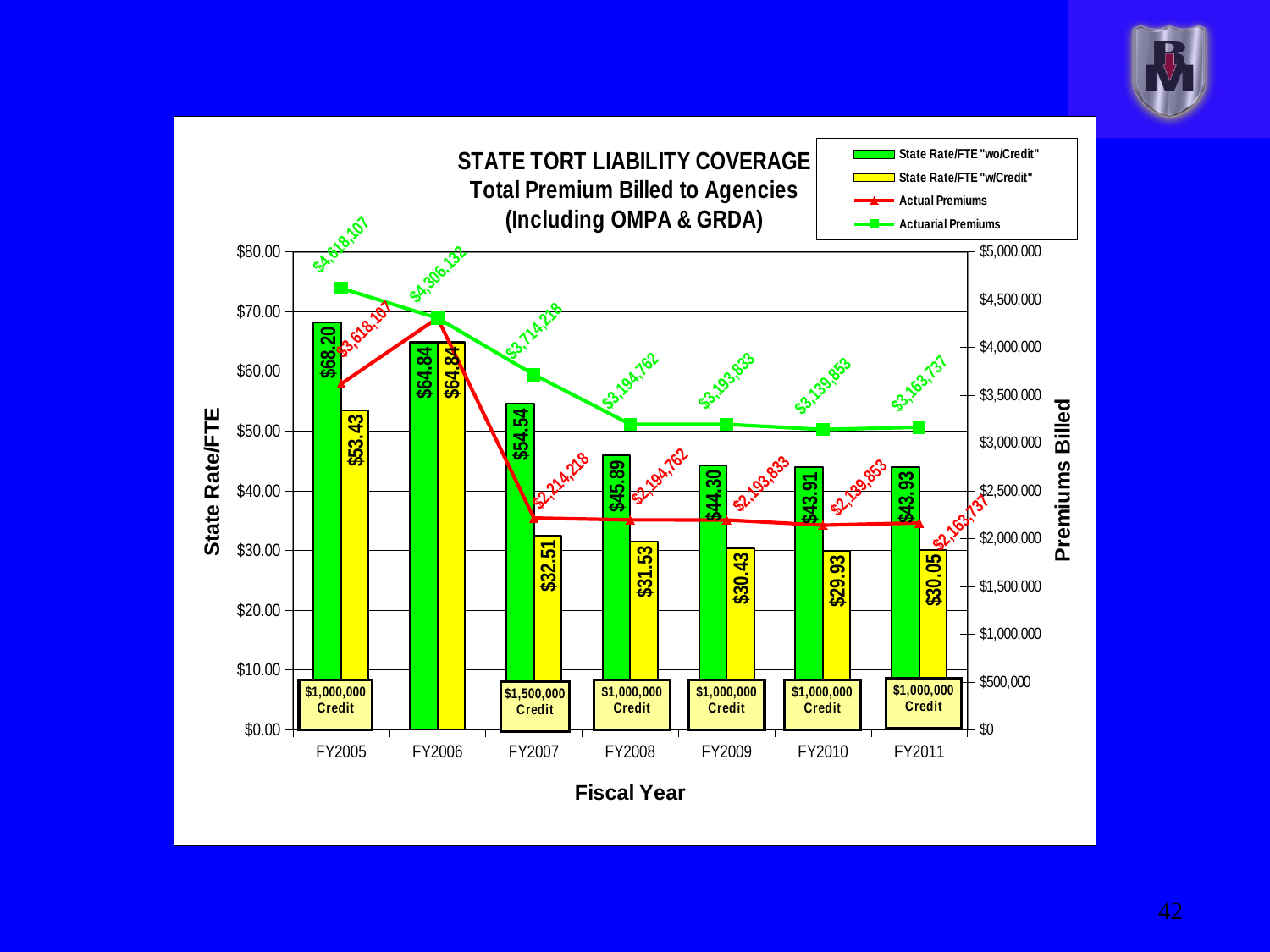
How many fiscal years are shown on the x axis? 7 What is the Actuarial Premiums value for FY2005? $4,618,107 What is the State Rate/FTE "w/Credit" value for FY2007? $32.51 Which fiscal year has the highest State Rate/FTE "wo/Credit"? FY2005 What is the difference between the State Rate/FTE "wo/Credit" and "w/Credit" values for FY2005? $14.77 Which is larger, the State Rate/FTE "wo/Credit" for FY2008 or for FY2009? FY2008 Which fiscal year has the lowest State Rate/FTE "w/Credit"? FY2010 How many series does the legend list? 4 What credit amount is shown for FY2007? $1,500,000 Credit What is the Actual Premiums value for FY2007? $2,214,218 What is the State Rate/FTE "wo/Credit" value for FY2005? $68.20 Is the Actual Premiums value for FY2010 greater or less than $2,500,000? less